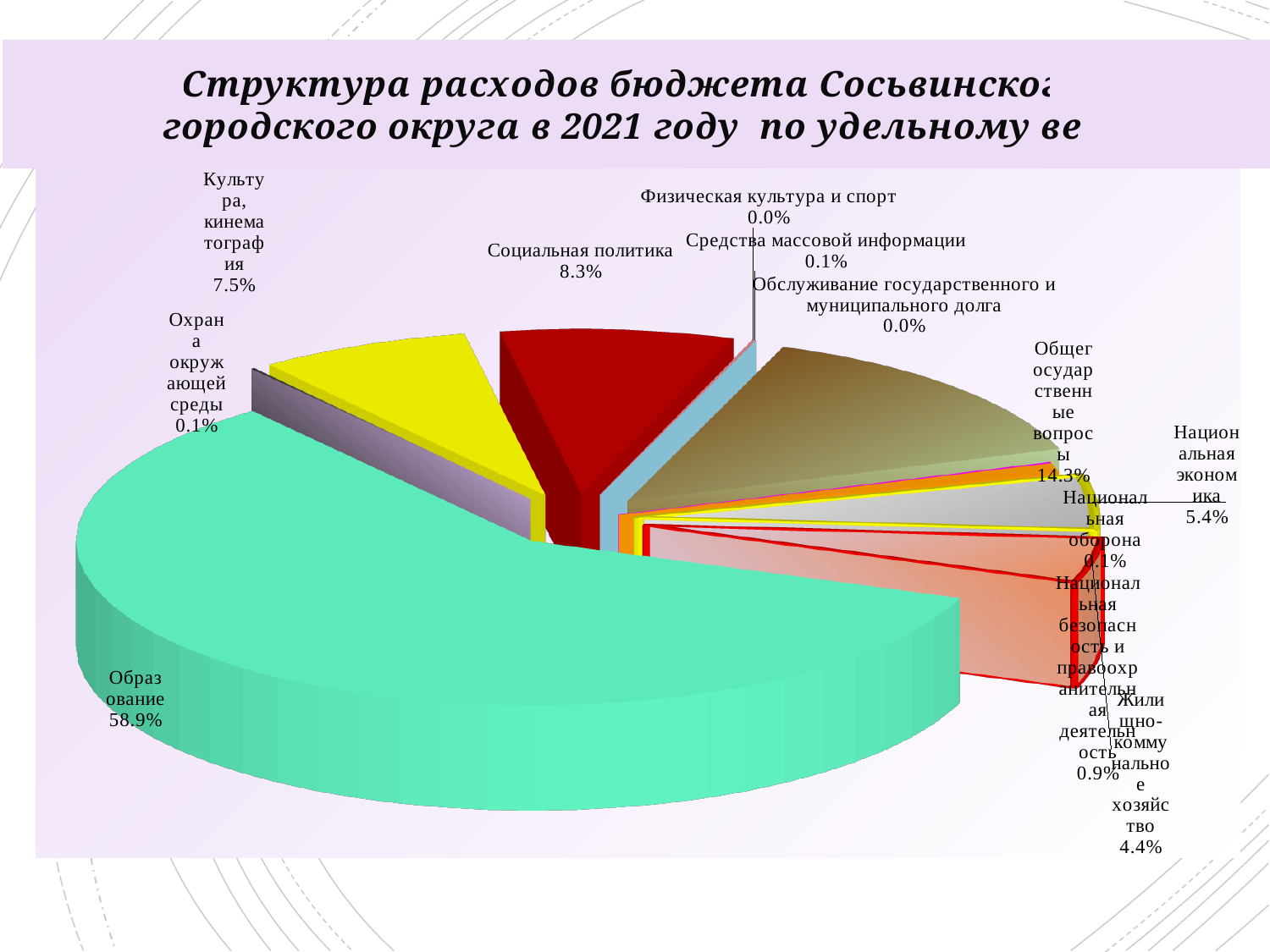
Which year does the chart title refer to? 2021 Which category has the largest share of the pie? Образование What is the value for Общегосударственные вопросы? 14.3% What share of the pie does Образование have? 58.9% What is the value for Национальная безопасность и правоохранительная деятельность? 0.9% Which is larger, Культура, кинематография or Социальная политика? Социальная политика What kind of chart is shown on the slide? pie chart What is the value for Национальная экономика? 5.4% What is the value for Жилищно-коммунальное хозяйство? 4.4% What is the value for Социальная политика? 8.3% How many categories are shown in the pie chart? 12 What is the difference between the shares of Общегосударственные вопросы and Национальная экономика? 8.9%